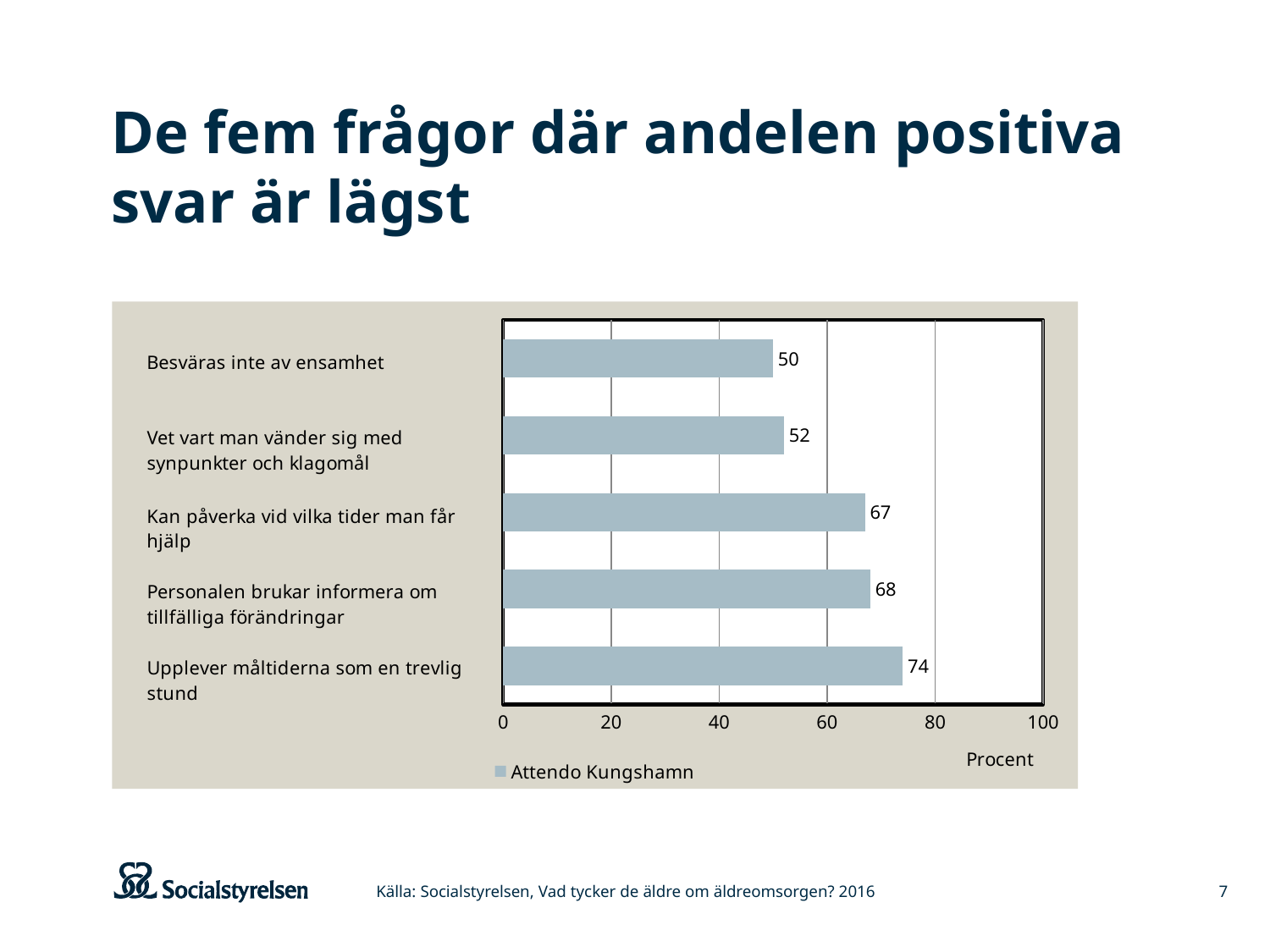
How many series does the legend list? 1 What is the value for "Kan påverka vid vilka tider man får hjälp"? 67 What is the value for "Besväras inte av ensamhet"? 50 Which is larger: the value for "Vet vart man vänder sig med synpunkter och klagomål" or the value for "Personalen brukar informera om tillfälliga förändringar"? Personalen brukar informera om tillfälliga förändringar What kind of chart is shown on the slide? bar chart What is the value for "Upplever måltiderna som en trevlig stund"? 74 Which category has the lowest value? Besväras inte av ensamhet What is the difference between the values for "Upplever måltiderna som en trevlig stund" and "Besväras inte av ensamhet"? 24 What series name is shown in the legend? Attendo Kungshamn Which category has the highest value? Upplever måltiderna som en trevlig stund How many categories are shown in the chart? 5 Is the value for "Vet vart man vänder sig med synpunkter och klagomål" greater or less than 60? less